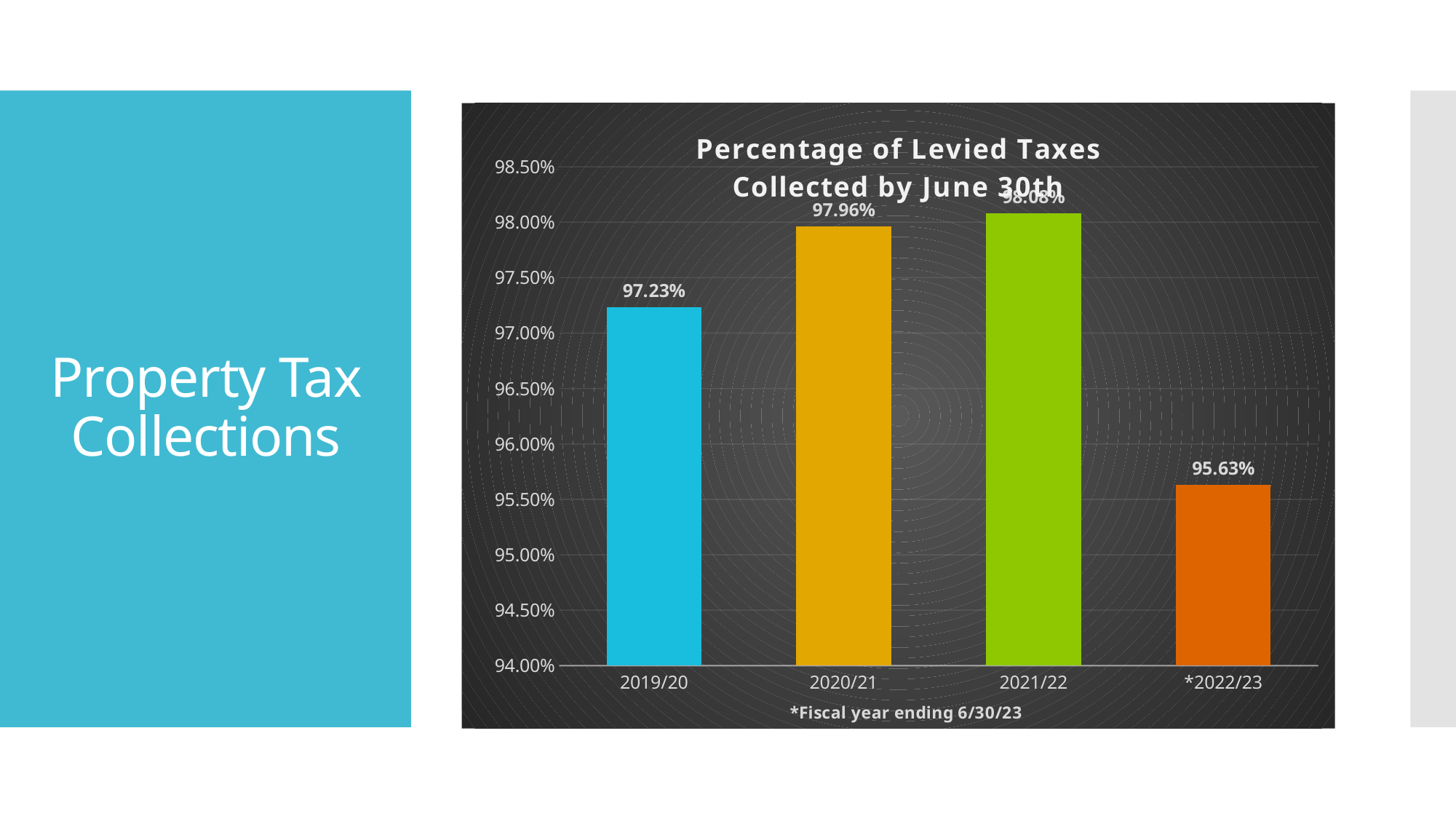
What is the title of the chart? Percentage of Levied Taxes Collected by June 30th What kind of chart is shown on the slide? bar chart Is the value for *2022/23 greater or less than 96.00%? less Which fiscal year has the lowest percentage of levied taxes collected? *2022/23 Which fiscal year has the highest percentage of levied taxes collected? 2021/22 How many fiscal years are shown on the chart? 4 What percentage of levied taxes was collected by June 30th in 2019/20? 97.23% What is the value shown for 2020/21? 97.96% What is the value shown for *2022/23? 95.63% What is the difference between the 2019/20 and *2022/23 values? 1.60% What is the difference between the 2020/21 and 2019/20 values? 0.73% Which is larger, the value for 2019/20 or the value for 2020/21? 2020/21